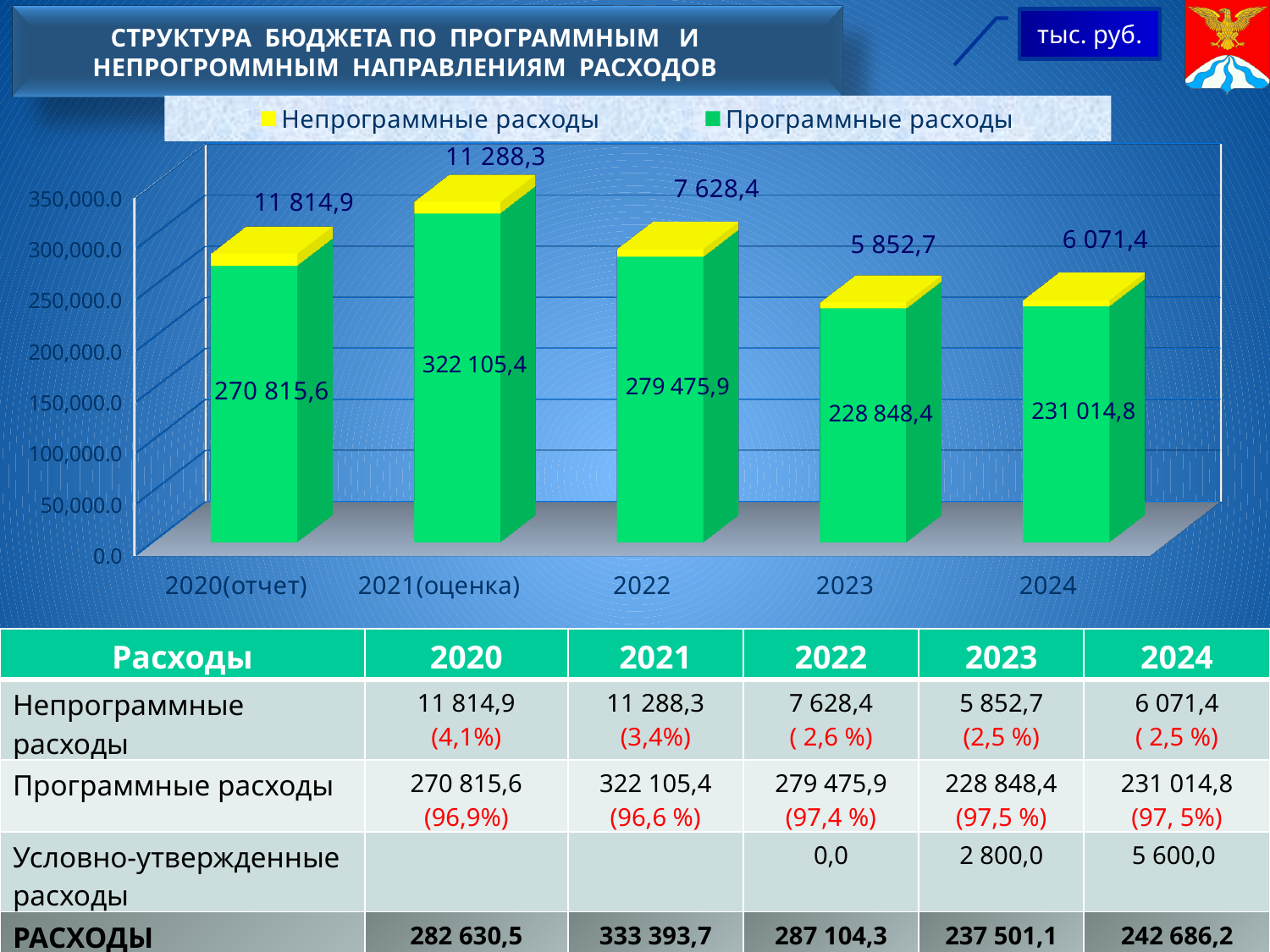
Which category has the lowest value for Непрограммные расходы? 2023 How many categories are shown on the x axis? 5 What is the difference between Программные расходы in 2021(оценка) and 2020(отчет)? 51 289,8 What is the value of Непрограммные расходы for 2023? 5 852,7 Which is larger: Непрограммные расходы in 2020(отчет) or in 2021(оценка)? 2020(отчет) What is the value of Программные расходы for 2022? 279 475,9 What is the total of the stacked bar for 2021(оценка)? 333 393,7 How many series does the legend list? 2 Which colour represents Непрограммные расходы in the chart? yellow Is the value of Программные расходы for 2023 greater or less than 250,000.0? less Which category has the highest value for Программные расходы? 2021(оценка) What kind of chart is shown on the slide? stacked bar chart